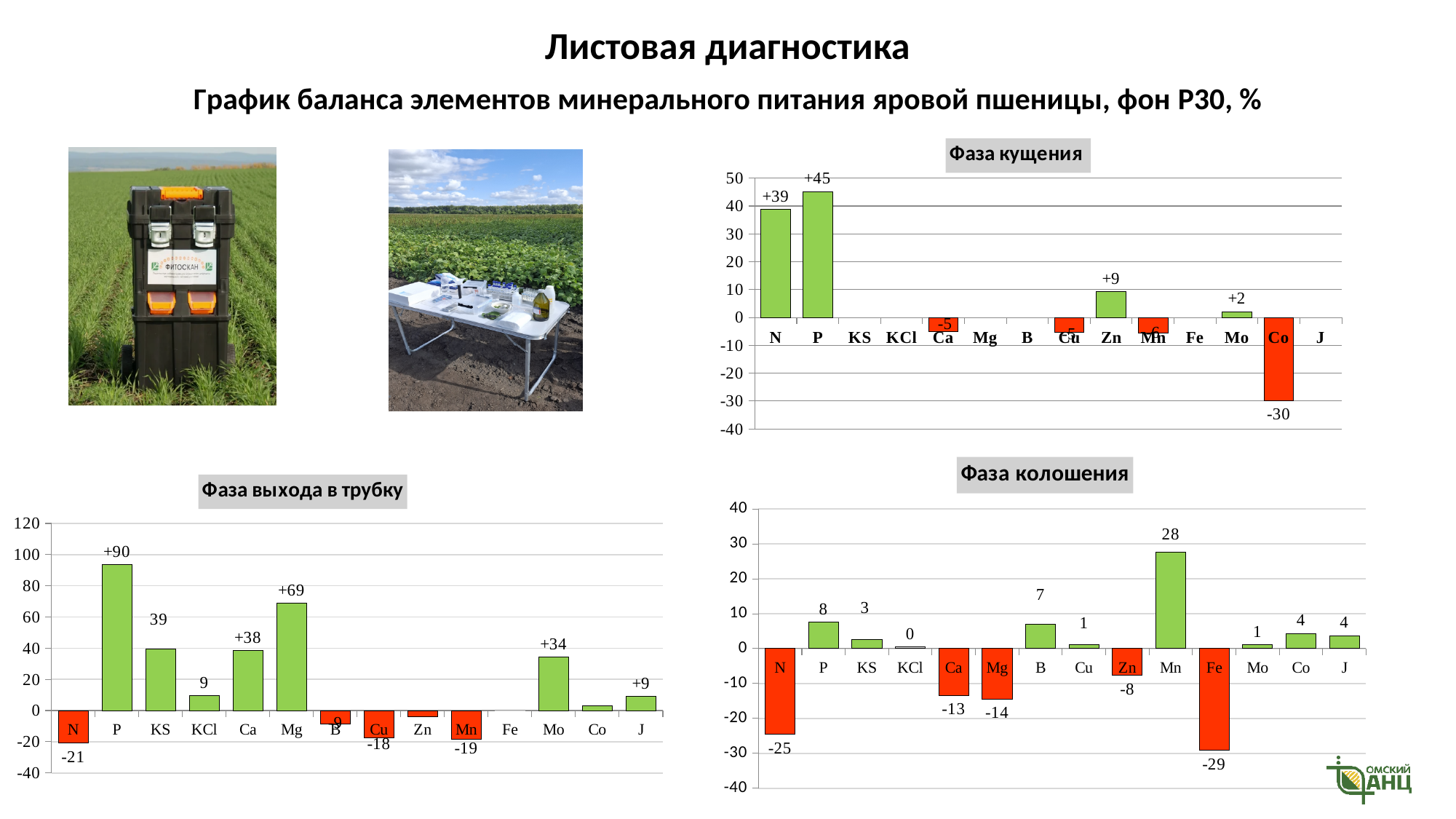
In the 'Фаза выхода в трубку' chart, what is the value for Mg? +69 In the 'Фаза кущения' chart, which element has the lowest value? Co What type of chart is the 'Фаза колошения' chart? Bar chart In the 'Фаза колошения' chart, which element has the lowest value? Fe In the 'Фаза кущения' chart, what is the value for Co? -30 How many elements are shown on the x axis of the 'Фаза колошения' chart? 14 In the 'Фаза выхода в трубку' chart, which is larger, the value for Ca or the value for Mo? Ca In the 'Фаза колошения' chart, what is the value for Mn? 28 In the 'Фаза кущения' chart, what is the value for P? +45 In the 'Фаза выхода в трубку' chart, what is the difference between the values for P and KS? 51 In the 'Фаза кущения' chart, which element has the highest value? P In the 'Фаза выхода в трубку' chart, is the value for P greater or less than 80? greater